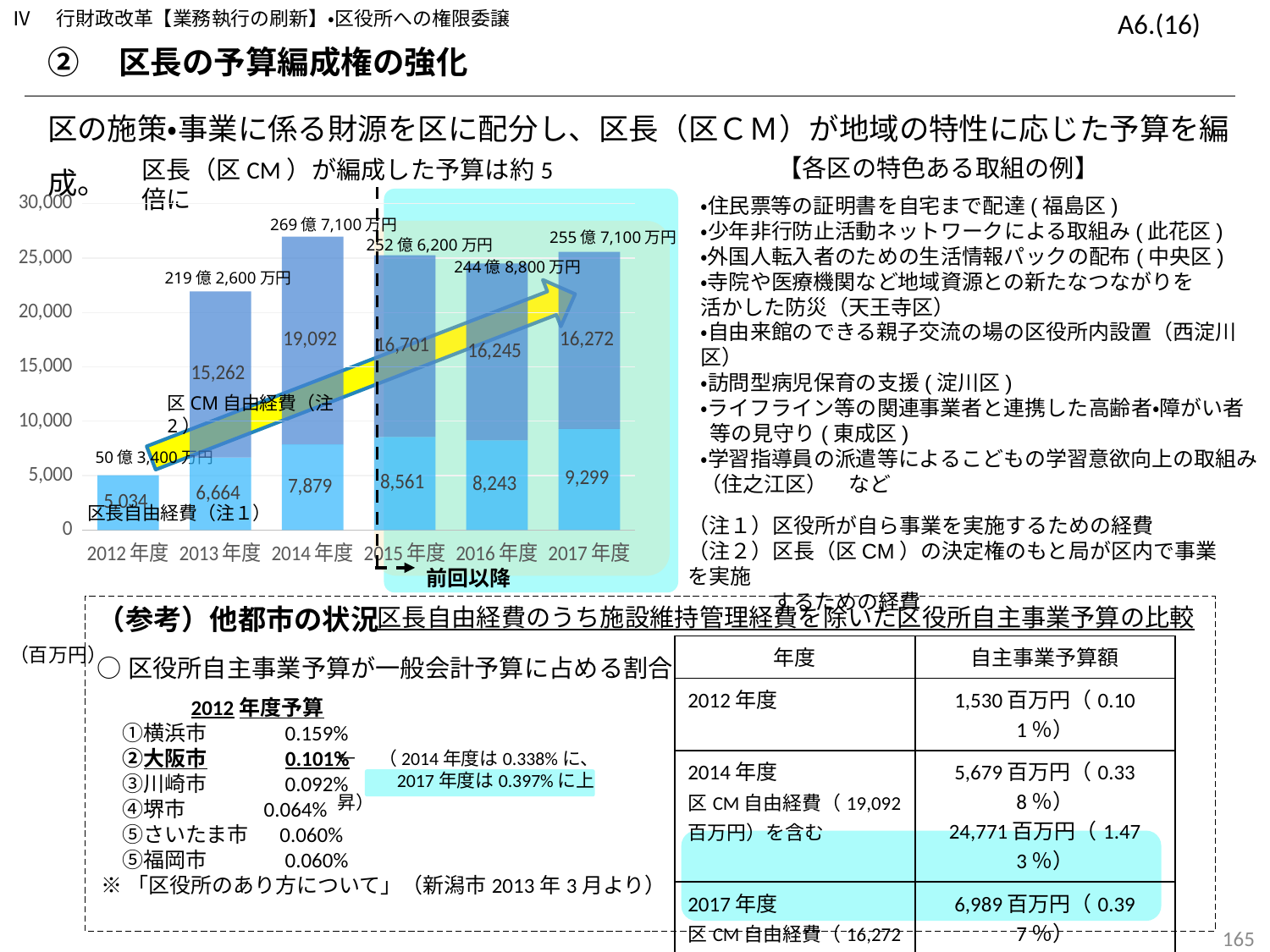
What is the value of 区長自由経費（注1） for 2014年度? 7,879 What is the total budget label shown above the 2014年度 bar? 269億7,100万円 What is the difference between the 区長自由経費（注1） values for 2017年度 and 2016年度? 1,056 What is the value of 区CM自由経費（注2） for 2013年度? 15,262 Which is larger, the 区CM自由経費（注2） value for 2015年度 or for 2017年度? 2015年度 What is the value of 区長自由経費（注1） for 2017年度? 9,299 Which fiscal year has the highest value for 区CM自由経費（注2）? 2014年度 What is the difference between the 区CM自由経費（注2） values for 2014年度 and 2013年度? 3,830 Which fiscal year has the lowest value for 区長自由経費（注1）? 2012年度 How many fiscal years (categories) are shown on the x axis of the bar chart? 6 What is the total budget label shown above the 2012年度 bar? 50億3,400万円 What type of chart is shown on the slide? stacked bar chart